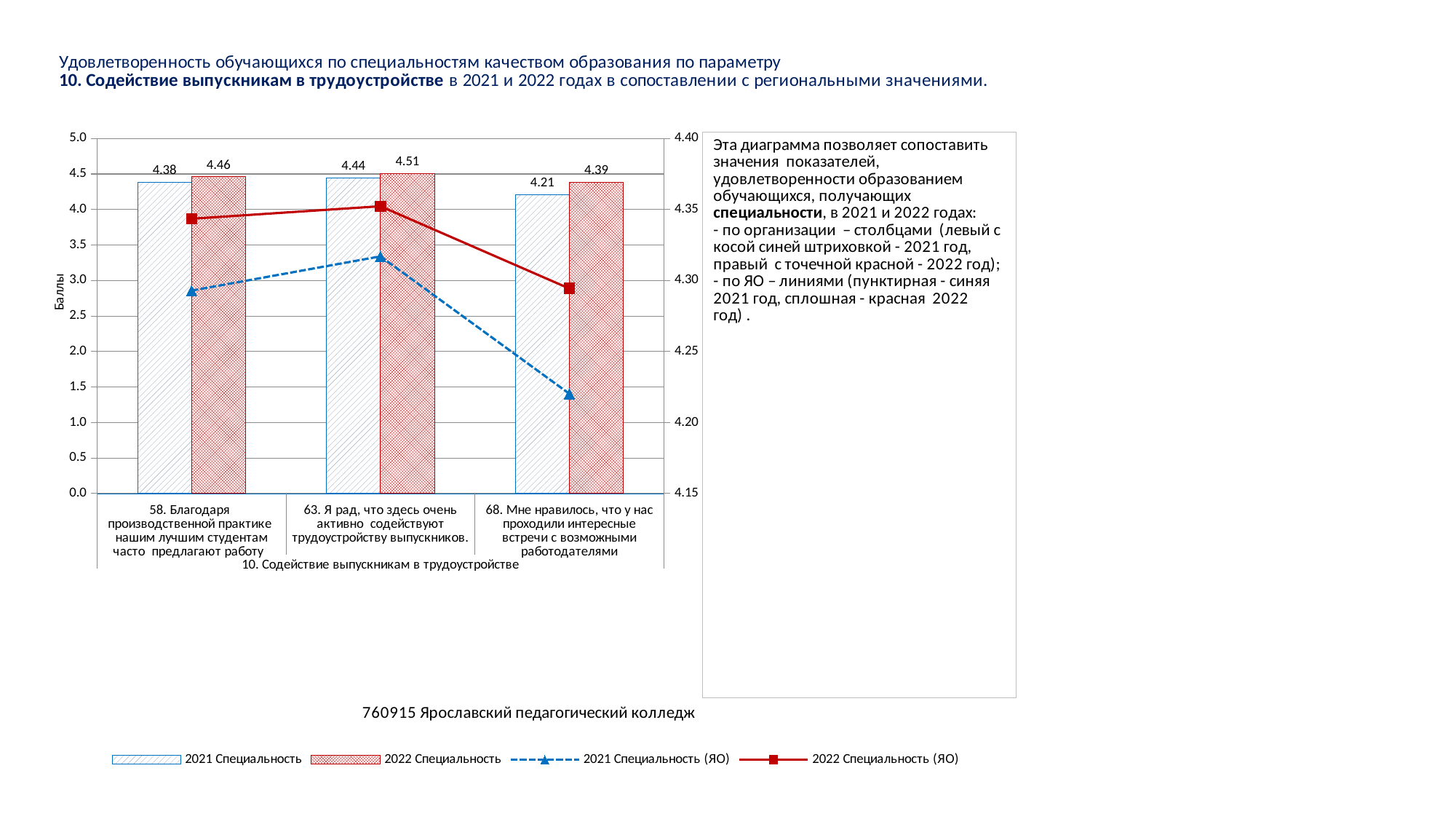
What is the value of the 2021 Специальность bar for category 63 (Я рад, что здесь очень активно содействуют трудоустройству выпускников)? 4.44 What is the difference between the 2022 Специальность and 2021 Специальность bars for category 68? 0.18 Which category has the highest 2022 Специальность bar? 63. Я рад, что здесь очень активно содействуют трудоустройству выпускников. Is the value of the 2022 Специальность (ЯО) line for category 58 greater or less than 4.30 on the right axis? greater What is the value of the 2022 Специальность bar for category 68 (Мне нравилось, что у нас проходили интересные встречи с возможными работодателями)? 4.39 How many series does the legend list? 4 Is the value of the 2021 Специальность (ЯО) line for category 68 greater or less than 4.25 on the right axis? less What kind of chart is shown on the slide? Combined bar and line chart What is the value of the 2022 Специальность bar for category 58 (Благодаря производственной практике нашим лучшим студентам часто предлагают работу)? 4.46 How many categories are shown on the x axis of the chart? 3 For category 58, which bar is larger: 2021 Специальность or 2022 Специальность? 2022 Специальность Which category has the lowest 2021 Специальность bar? 68. Мне нравилось, что у нас проходили интересные встречи с возможными работодателями